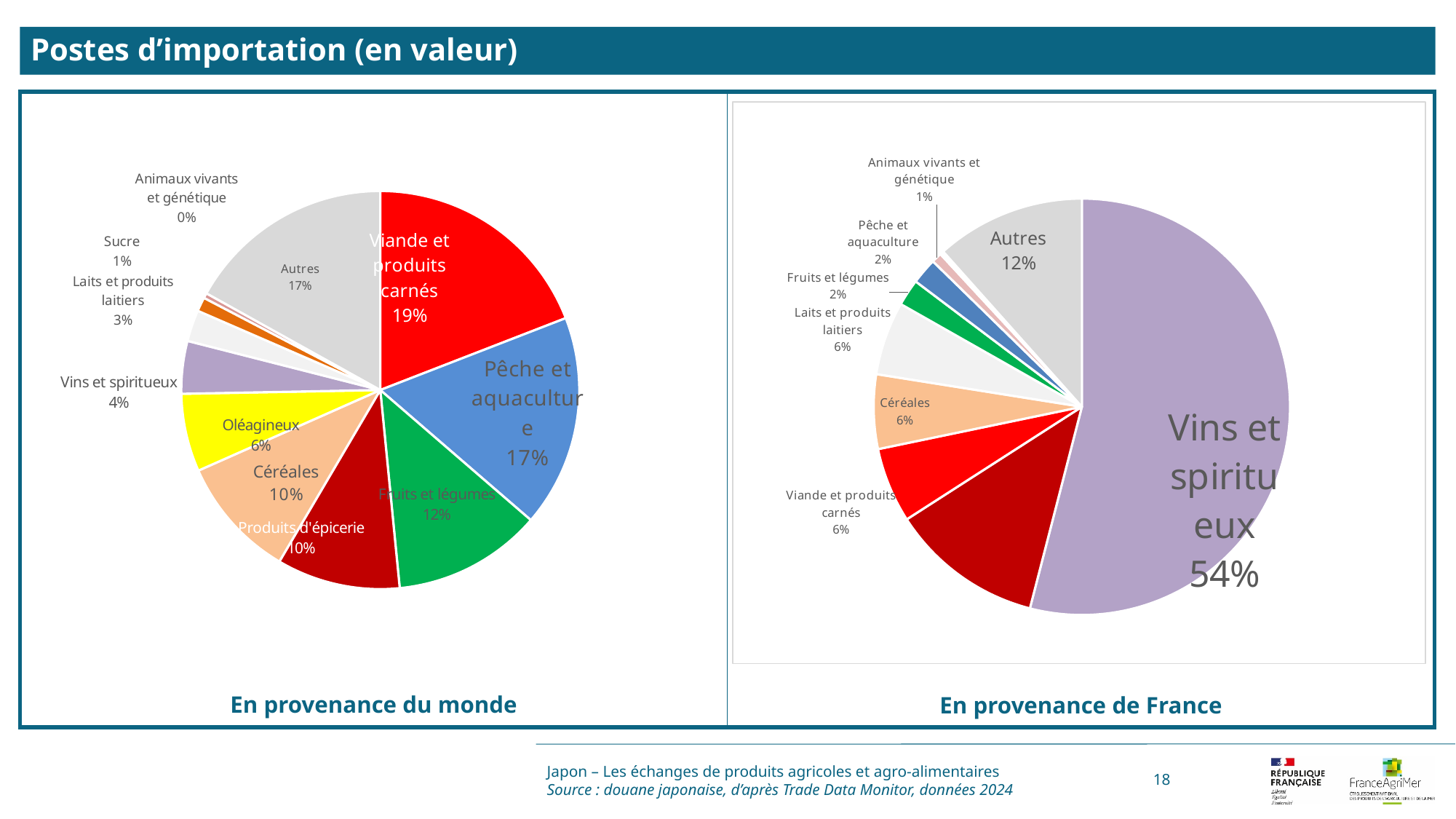
In the 'En provenance du monde' pie chart, what share is shown for Viande et produits carnés? 19% In the 'En provenance du monde' pie chart, what share is shown for Oléagineux? 6% What is the title of the slide? Postes d'importation (en valeur) In the 'En provenance de France' pie chart, what share is shown for Vins et spiritueux? 54% In the 'En provenance de France' pie chart, which is larger, the share of Céréales or the share of Fruits et légumes? Céréales In the 'En provenance du monde' pie chart, what is the difference between the shares of Fruits et légumes and Vins et spiritueux? 8 percentage points What type of chart is used for 'En provenance du monde'? Pie chart In the 'En provenance du monde' pie chart, which category has the largest share? Viande et produits carnés In the 'En provenance du monde' pie chart, which category has the smallest share? Animaux vivants et génétique